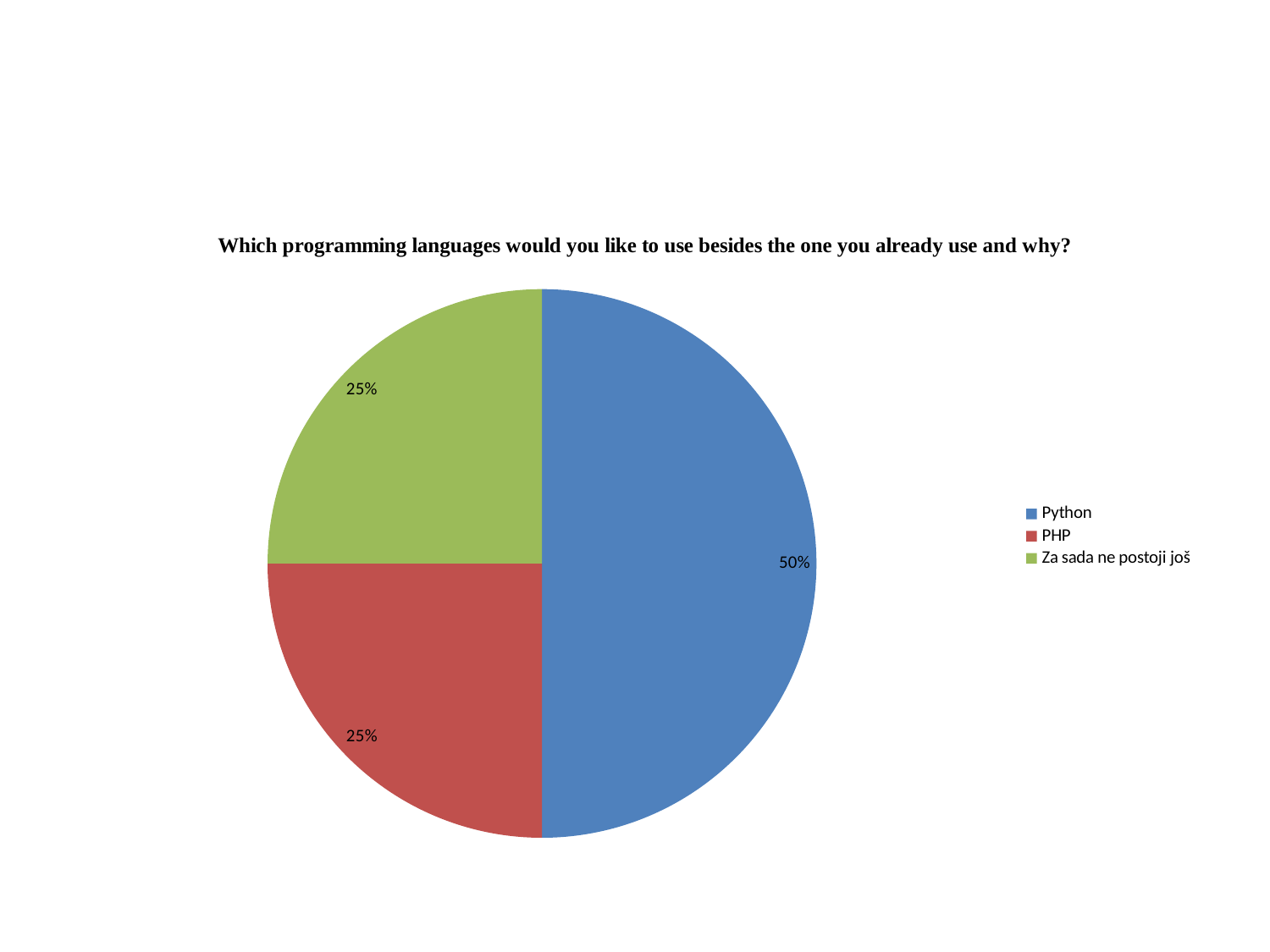
What is the title of the chart? Which programming languages would you like to use besides the one you already use and why? How many slices does the pie chart have? 3 What share of the pie does PHP have? 25% Which category has the largest slice of the pie? Python How many entries does the legend list? 3 What colour is the Python slice? blue Which is larger, the share for Python or the share for PHP? Python What kind of chart is shown on the slide? pie chart What is the difference between the Python share and the PHP share? 25% What share of the pie does Python have? 50% What share of the pie does "Za sada ne postoji još" have? 25%